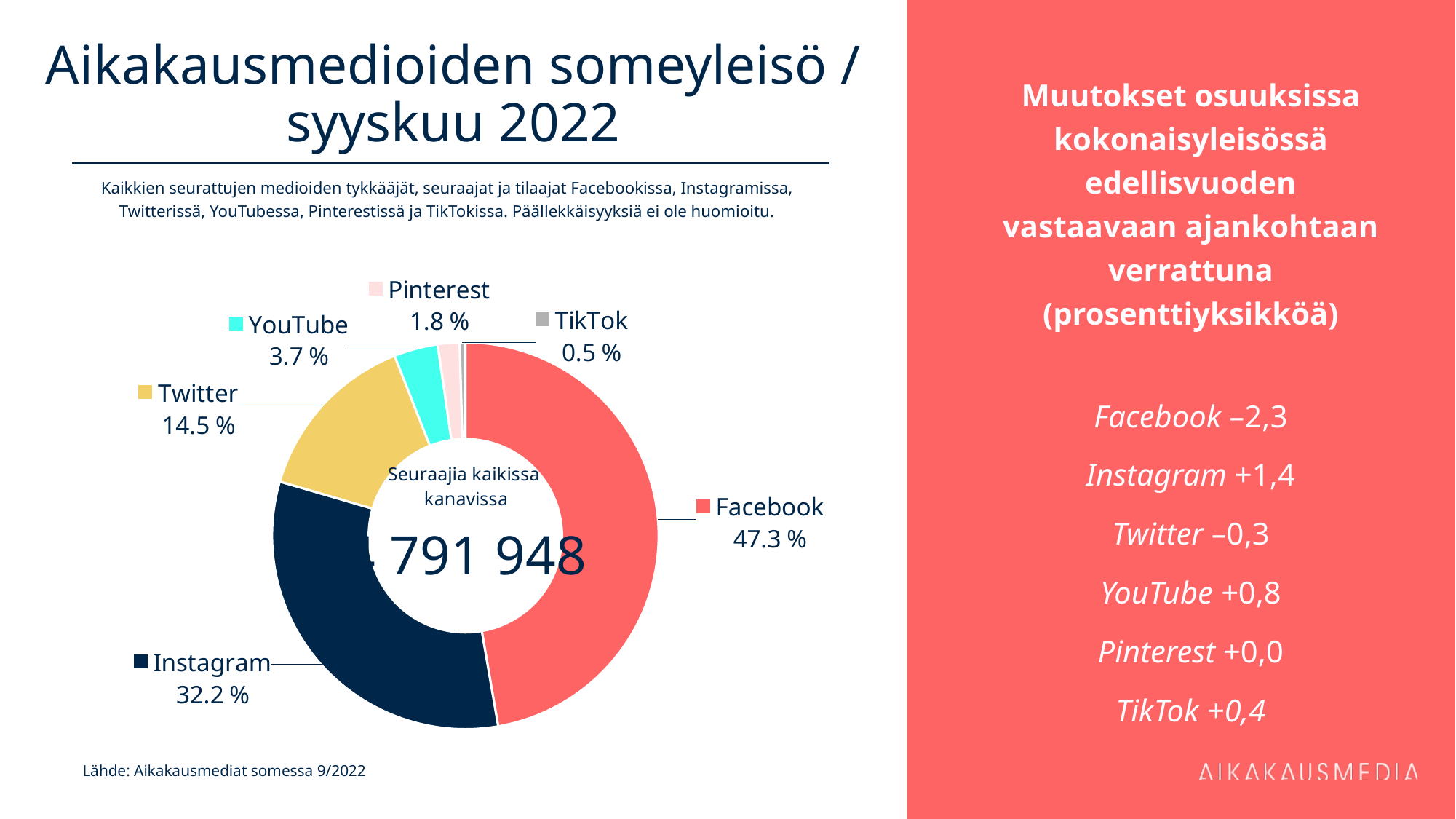
Which channel has the largest share of the audience? Facebook What share of the social media audience does YouTube hold? 3.7 % What share of the social media audience does Facebook hold? 47.3 % What share of the social media audience does Instagram hold? 32.2 % How many percentage points larger is Facebook's share than Instagram's share? 15.1 Which channel has the smallest share of the audience? TikTok What share of the social media audience does Twitter hold? 14.5 % What type of chart is used on the slide? Pie (donut) chart What share of the social media audience does TikTok hold? 0.5 % What colour is the Twitter slice in the chart? Yellow Which has a larger share, Twitter or YouTube? Twitter How many channels are shown in the chart? 6